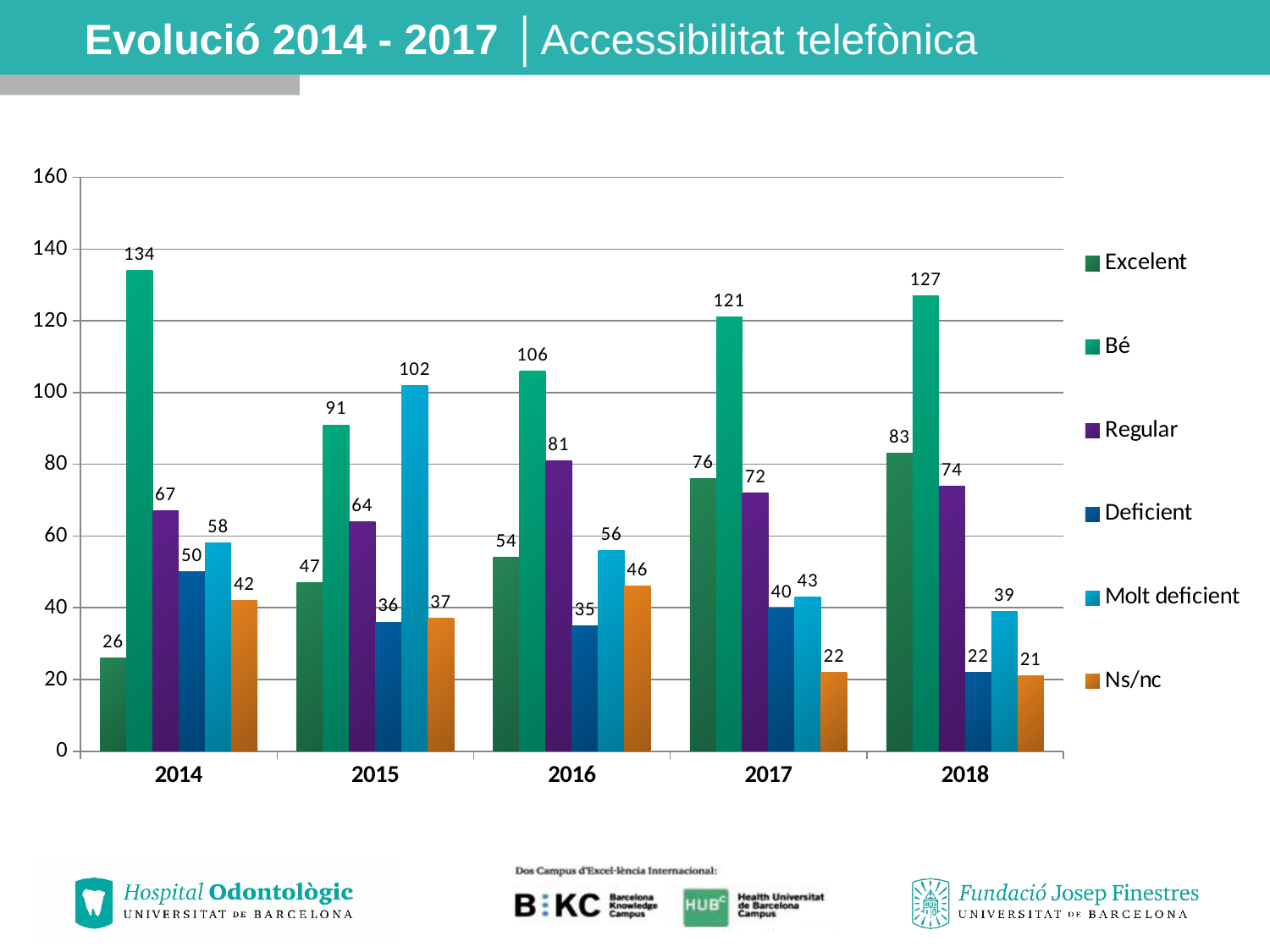
What kind of chart is shown on the slide? bar chart What is the value for Bé in 2014? 134 In which year is the Excelent value lowest? 2014 What is the value for Molt deficient in 2015? 102 What is the difference between the Bé value in 2018 and the Bé value in 2017? 6 How many years are shown on the x axis? 5 Which is larger in 2016: Regular or Molt deficient? Regular What is the value for Excelent in 2018? 83 How many series does the legend list? 6 Does the Excelent value rise or fall from 2014 to 2018? rise In which year is the Bé value highest? 2014 Is the value for Bé in 2015 greater or less than 100? less